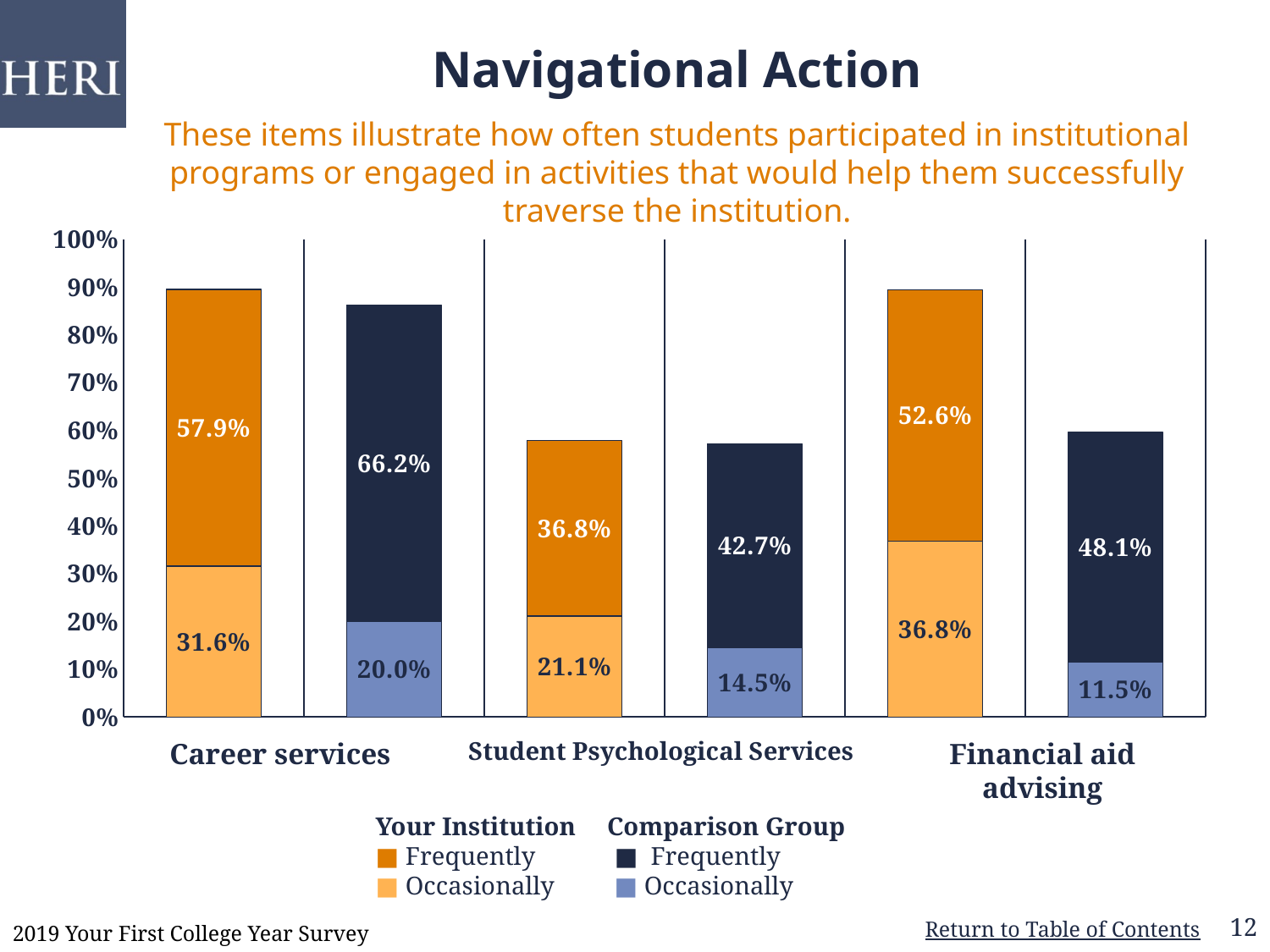
How many categories are shown on the x axis? 3 Which category has the highest Comparison Group Frequently value? Career services What percentage of students at Your Institution reported using Career services Frequently? 57.9% For Financial aid advising, which is larger: the Your Institution Frequently value or the Comparison Group Frequently value? Your Institution Frequently What is the Your Institution Occasionally value for Student Psychological Services? 21.1% Which category has the lowest Your Institution Frequently value? Student Psychological Services What is the Comparison Group's Occasionally value for Financial aid advising? 11.5% What is the total of the Comparison Group stacked bar for Financial aid advising? 59.6% What is the difference between the Comparison Group Frequently value and the Your Institution Frequently value for Career services? 8.3% What is the total of the Your Institution stacked bar for Career services? 89.5% What kind of chart is shown on the slide? Stacked bar chart How many series does the legend list? 4